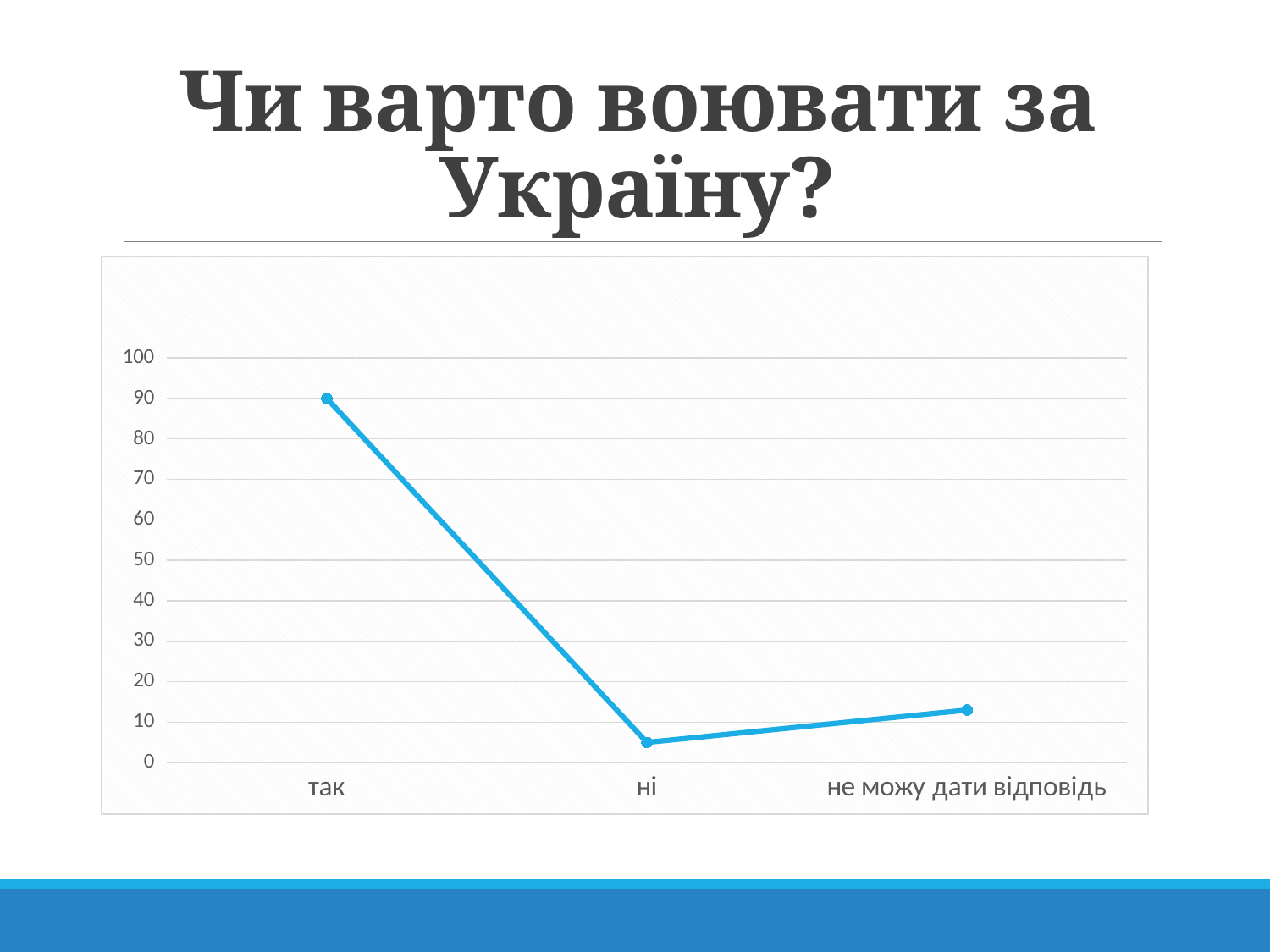
How many categories are plotted on the x axis? 3 What kind of chart is shown on the slide? line chart What is the value for так? 90 Does the line rise or fall from так to ні? fall Is the value for не можу дати відповідь greater or less than 20? less Is the value for не можу дати відповідь greater or less than 10? greater Which category has the lowest value? ні Which is larger, the value for ні or the value for не можу дати відповідь? не можу дати відповідь Is the value for так greater or less than 80? greater What is the title of the slide? Чи варто воювати за Україну? Which category has the highest value? так